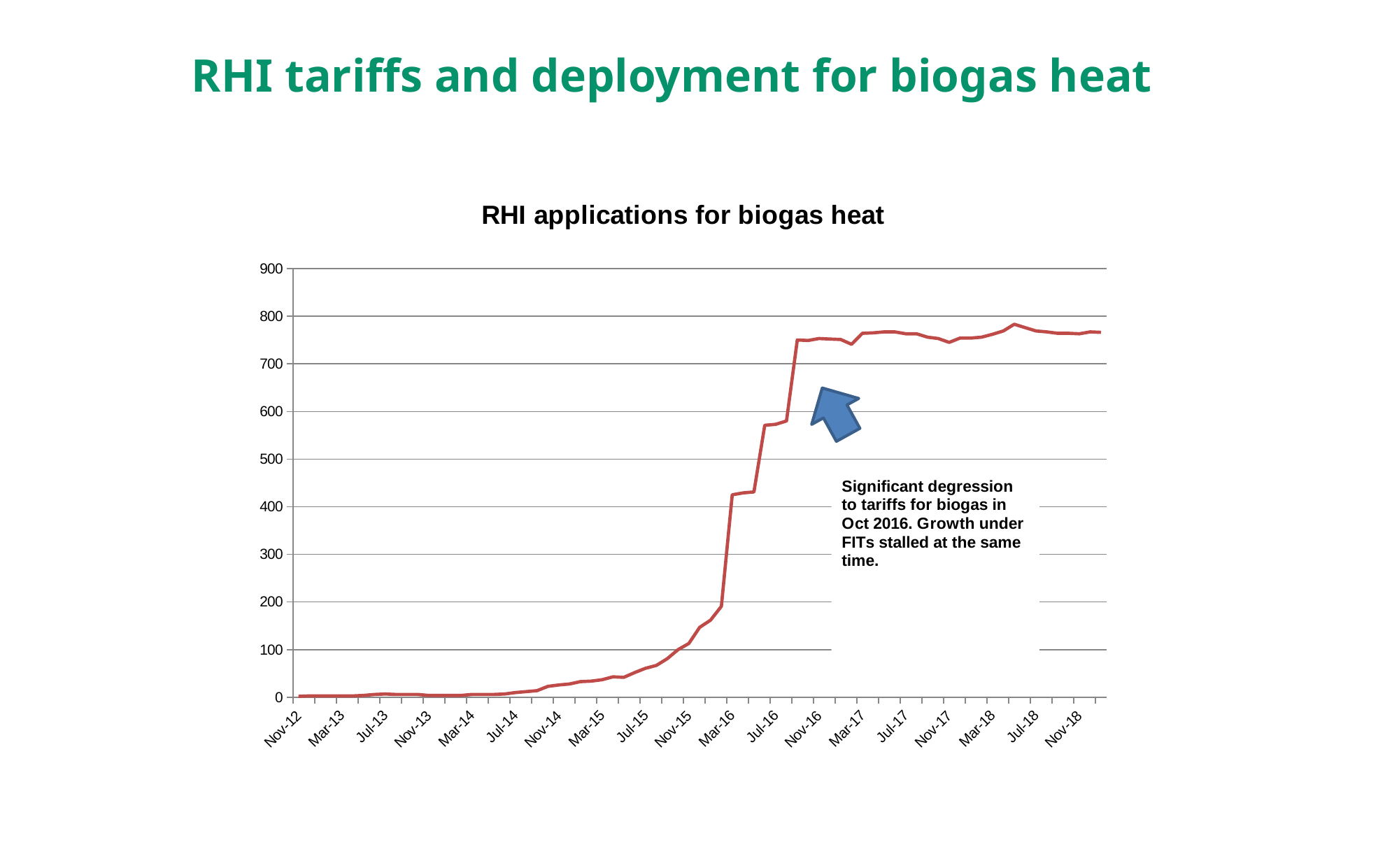
Is the value for Jul-15 greater or less than 100? less How many date labels are shown along the x axis? 19 Do the values generally rise or fall from Nov-12 to Nov-16? rise What is the title of the chart? RHI applications for biogas heat Is the value for Nov-14 greater or less than 100? less Is the value for Nov-12 greater or less than 100? less What is the highest value shown on the y axis? 900 What kind of chart is shown on the slide? line chart Which has the larger value, Nov-16 or Jul-15? Nov-16